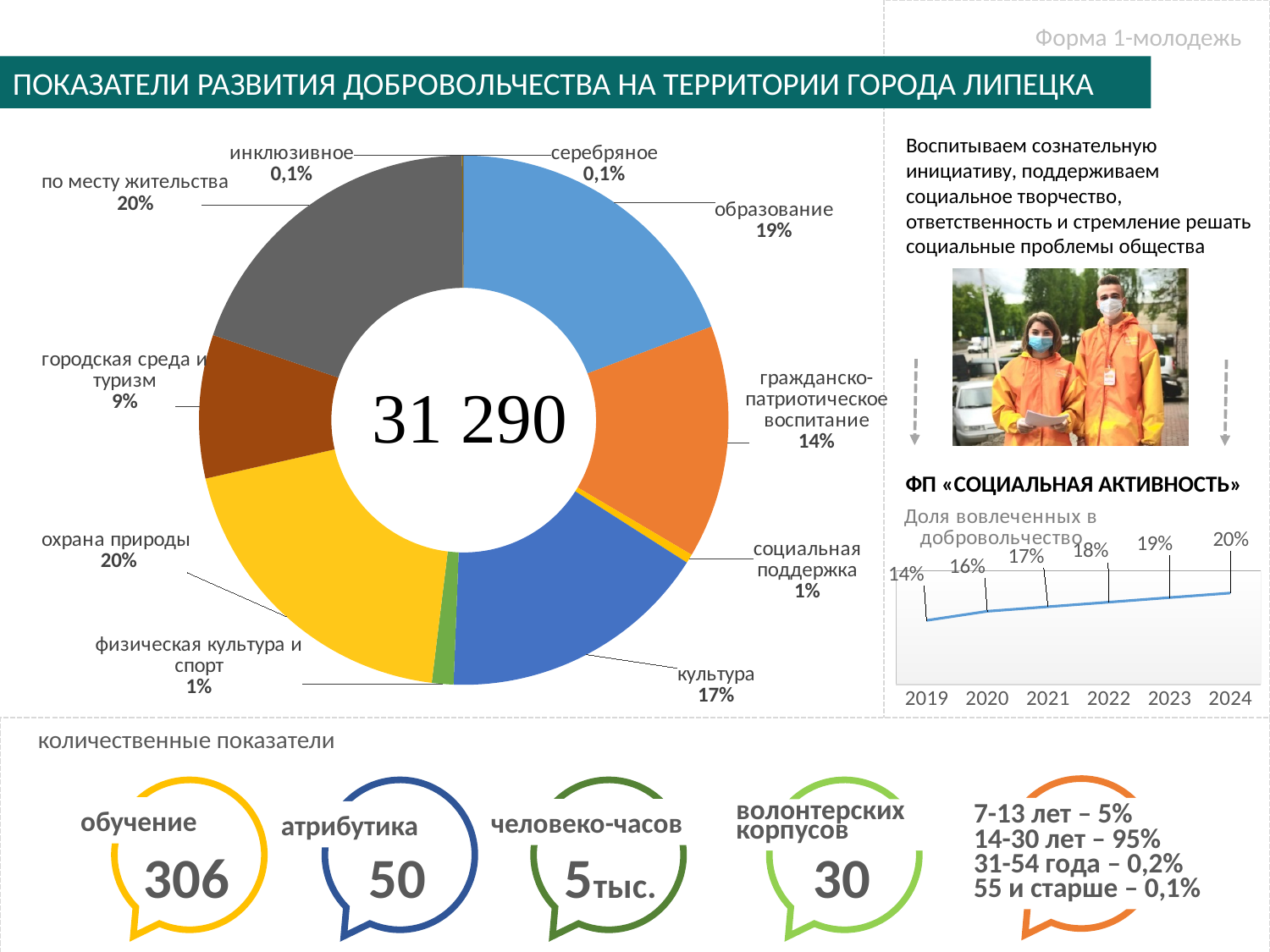
In the donut chart, what share is shown for культура? 17% In the chart 'Доля вовлеченных в добровольчество', what is the value for 2021? 17% In the donut chart, what share is shown for городская среда и туризм? 9% What number is printed in the centre of the donut chart? 31 290 In the donut chart, what share is shown for образование? 19% In the chart 'Доля вовлеченных в добровольчество', what is the difference between the values for 2024 and 2019? 6% In the donut chart, what is the difference between the shares of охрана природы and культура? 3% How many categories are shown in the donut chart? 10 In the chart 'Доля вовлеченных в добровольчество', which year has the highest value? 2024 What kind of chart is the large chart on the left of the slide? donut chart In the donut chart, which is larger: образование or гражданско-патриотическое воспитание? образование In the chart 'Доля вовлеченных в добровольчество', do the values rise or fall from 2019 to 2024? rise